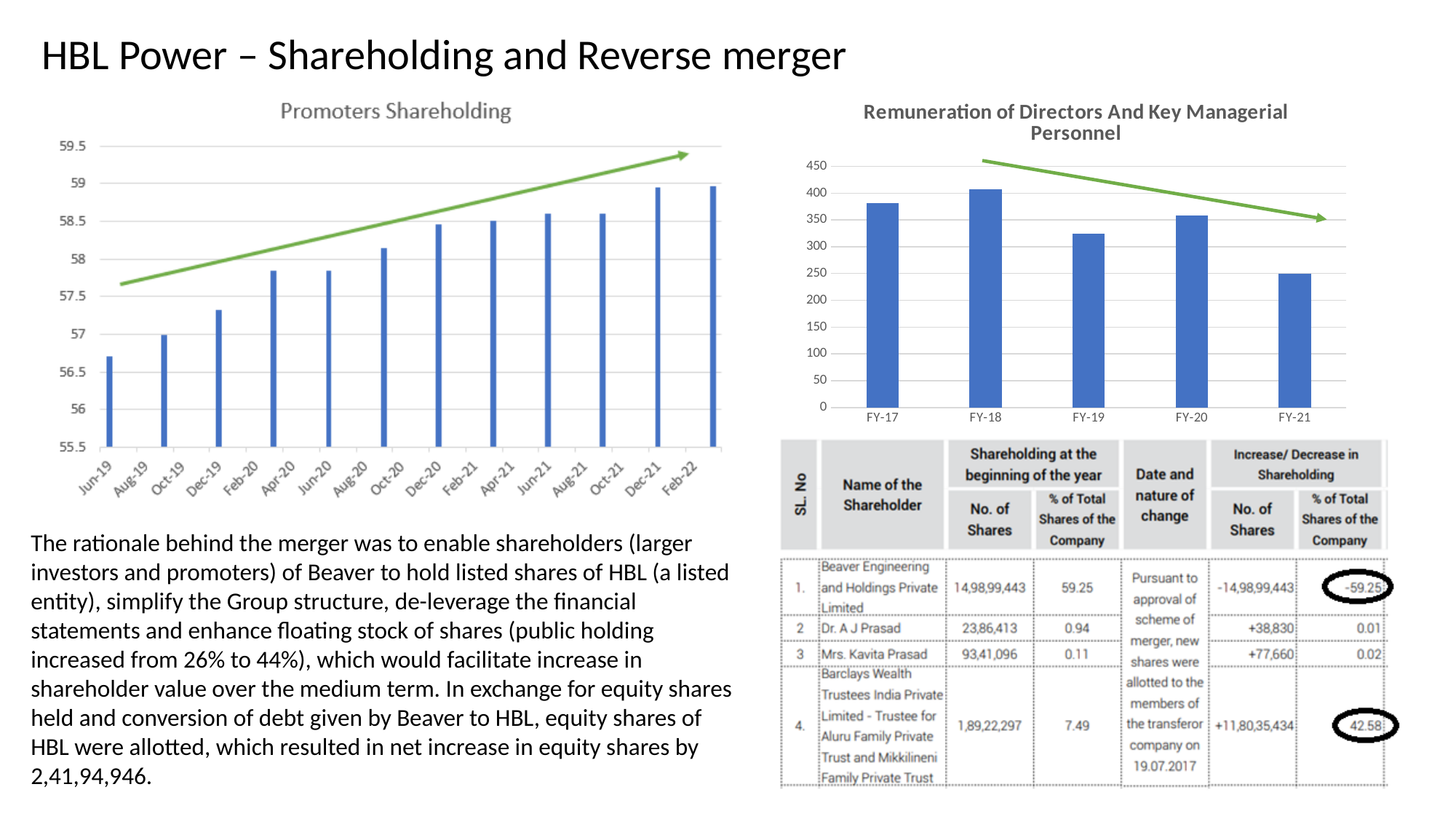
On the Remuneration of Directors And Key Managerial Personnel chart, is the value for FY-18 greater or less than 400? greater On the Remuneration of Directors And Key Managerial Personnel chart, how many fiscal years are plotted? 5 What is the title of the chart on the right side of the slide? Remuneration of Directors And Key Managerial Personnel On the Promoters Shareholding chart, do the values generally rise or fall from left to right? rise On the Remuneration of Directors And Key Managerial Personnel chart, what is the overall direction of the values from FY-17 to FY-21? falling On the Remuneration of Directors And Key Managerial Personnel chart, which fiscal year has the highest value? FY-18 On the Remuneration of Directors And Key Managerial Personnel chart, which fiscal year has the lowest value? FY-21 On the Remuneration of Directors And Key Managerial Personnel chart, is the value for FY-17 greater or less than 350? greater What kind of chart is the Promoters Shareholding chart? bar chart On the Remuneration of Directors And Key Managerial Personnel chart, which is larger, FY-17 or FY-19? FY-17 On the Remuneration of Directors And Key Managerial Personnel chart, is the value for FY-21 greater or less than 300? less